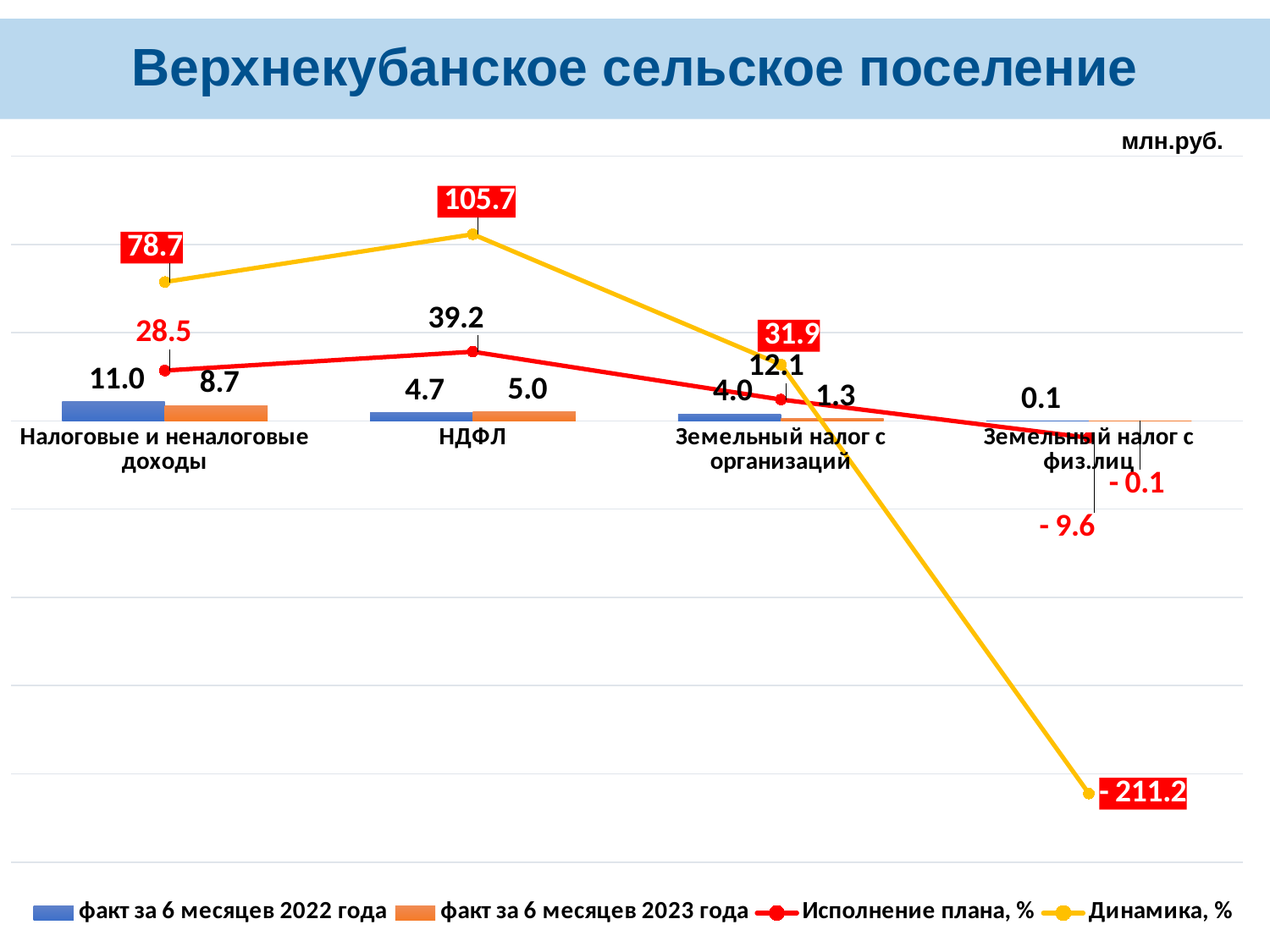
What is the 'Исполнение плана, %' value for 'Земельный налог с организаций'? 12.1 What is the 'Динамика, %' value for 'НДФЛ'? 105.7 What is the difference between the 2022 and 2023 values for 'Налоговые и неналоговые доходы'? 2.3 Which is larger for 'Земельный налог с организаций': the 2022 value or the 2023 value? факт за 6 месяцев 2022 года What is the value of 'факт за 6 месяцев 2023 года' for 'НДФЛ'? 5.0 How many series does the legend list? 4 What unit is indicated in the top right corner of the chart? млн.руб. What is the value of 'факт за 6 месяцев 2022 года' for 'Налоговые и неналоговые доходы'? 11.0 Which category has the lowest 'Динамика, %' value? Земельный налог с физ.лиц How many categories are shown on the x axis? 4 Which category has the highest 'Исполнение плана, %' value? НДФЛ What is the 'Динамика, %' value for 'Земельный налог с физ.лиц'? - 211.2